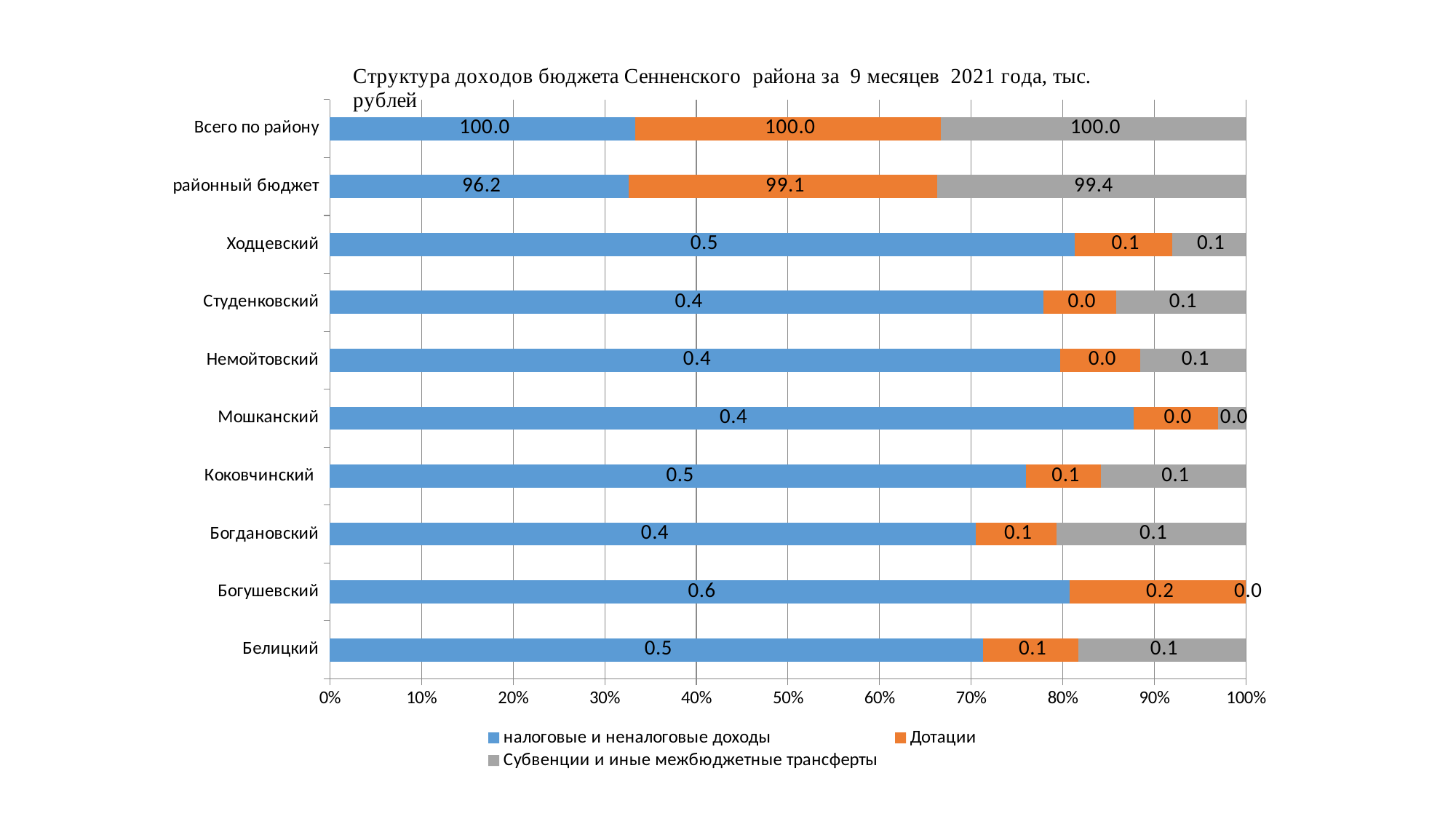
Is the share of the bar taken by налоговые и неналоговые доходы for Мошканский greater or less than 80%? greater What is the value of Субвенции и иные межбюджетные трансферты for районный бюджет? 99.4 What type of chart is shown on the slide? bar chart Which has the larger Дотации value, Богушевский or Белицкий? Богушевский What is the value of Дотации for Богушевский? 0.2 How many series does the legend list? 3 How many categories are shown on the vertical axis? 10 What colour represents Дотации in the legend? orange What is the value of налоговые и неналоговые доходы for районный бюджет? 96.2 What is the difference between the Субвенции и иные межбюджетные трансферты value and the Дотации value for районный бюджет? 0.3 What is the value of Дотации for районный бюджет? 99.1 Which category has the highest value for Дотации? Всего по району